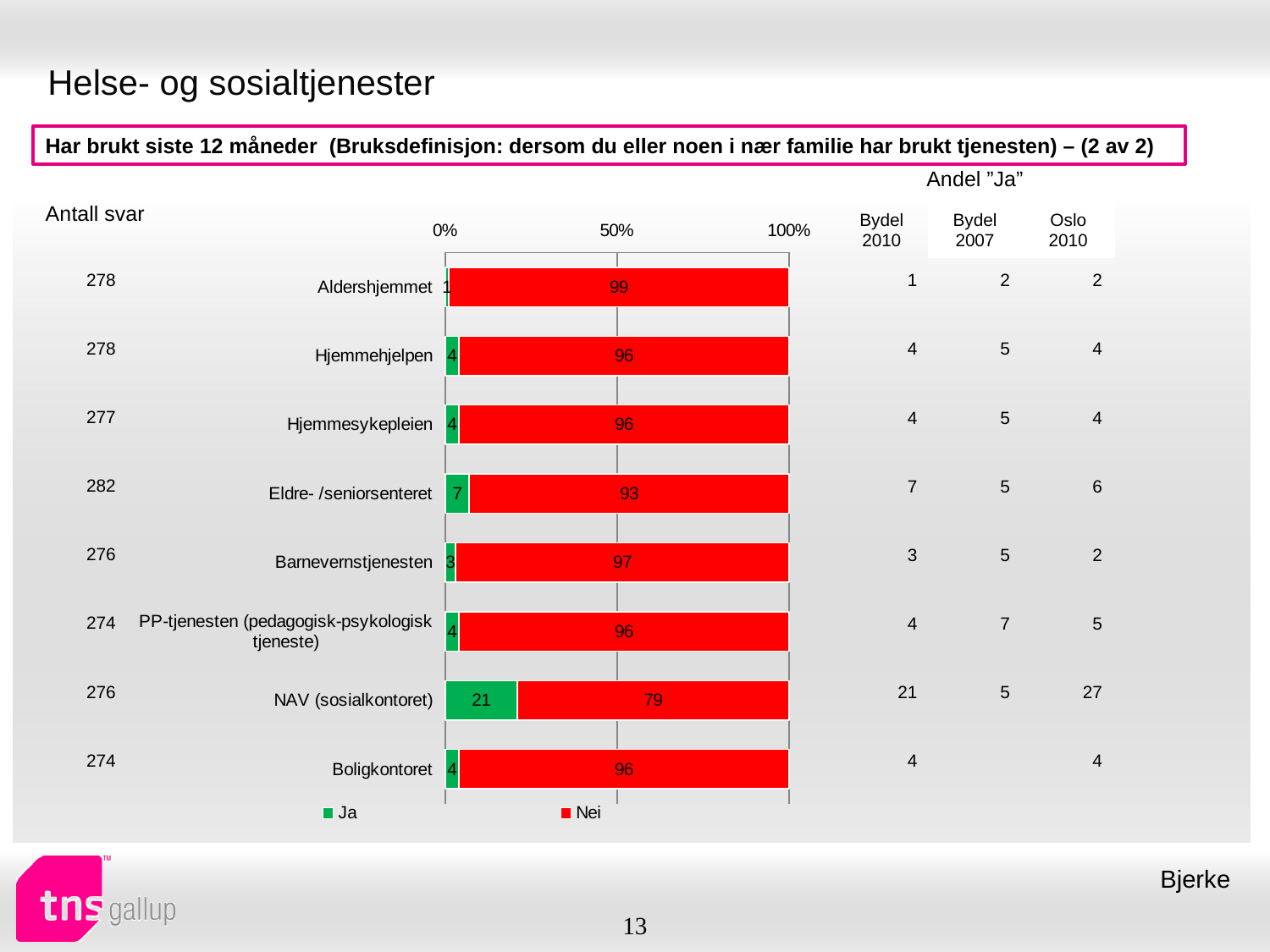
What is the 'Ja' value for NAV (sosialkontoret)? 21 Which category has the highest 'Ja' value? NAV (sosialkontoret) Which is larger, the 'Ja' value for Eldre- /seniorsenteret or the 'Ja' value for Barnevernstjenesten? Eldre- /seniorsenteret What is the difference between the 'Nei' values for Aldershjemmet and NAV (sosialkontoret)? 20 How many categories are shown in the chart? 8 What is the 'Nei' value for Aldershjemmet? 99 What kind of chart is shown on the slide? Stacked bar chart Is the 'Nei' value for NAV (sosialkontoret) greater or less than 50%? greater What is the 'Nei' value for Eldre- /seniorsenteret? 93 How many series does the legend list? 2 Which category has the lowest 'Ja' value? Aldershjemmet What are the two legend entries of the chart? Ja and Nei